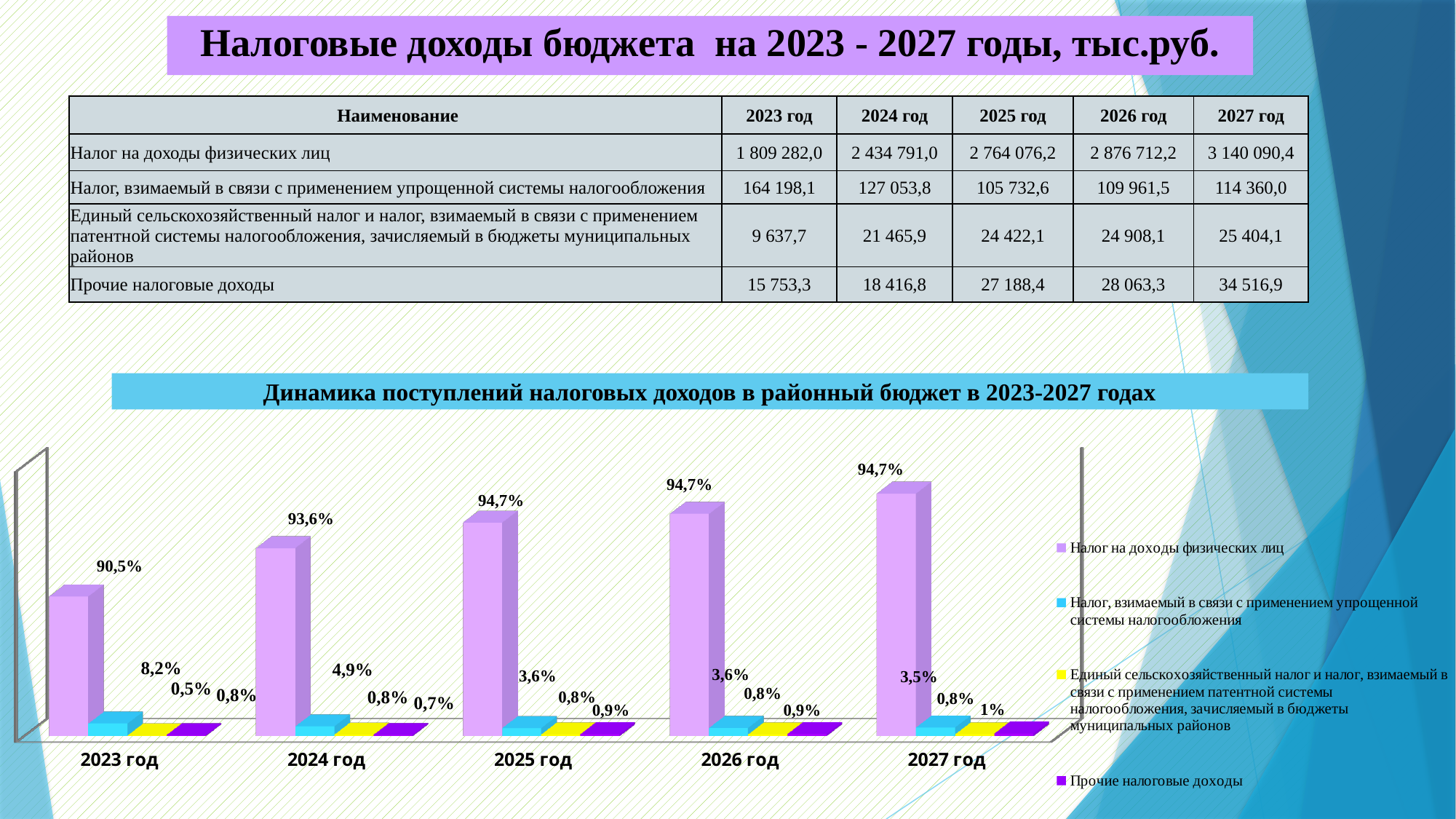
What kind of chart is shown under the title "Динамика поступлений налоговых доходов в районный бюджет в 2023-2027 годах"? bar chart In which year is the share of "Налог на доходы физических лиц" lowest on the chart? 2023 год What is the value for "Налог на доходы физических лиц" in 2023 год on the chart? 90,5% How many year categories are shown on the x axis of the chart? 5 What is the difference between the "Налог на доходы физических лиц" values for 2024 год and 2023 год on the chart? 3,1% In which year is the share of "Налог, взимаемый в связи с применением упрощенной системы налогообложения" highest on the chart? 2023 год What is the value for "Налог, взимаемый в связи с применением упрощенной системы налогообложения" in 2024 год on the chart? 4,9% What is the value for "Прочие налоговые доходы" in 2027 год on the chart? 1% Which is larger on the chart: the "Налог, взимаемый в связи с применением упрощенной системы налогообложения" value for 2023 год or for 2025 год? 2023 год Does the share of "Налог на доходы физических лиц" rise or fall from 2023 год to 2025 год on the chart? rise How many series does the chart legend list? 4 What colour represents "Прочие налоговые доходы" in the chart legend? purple